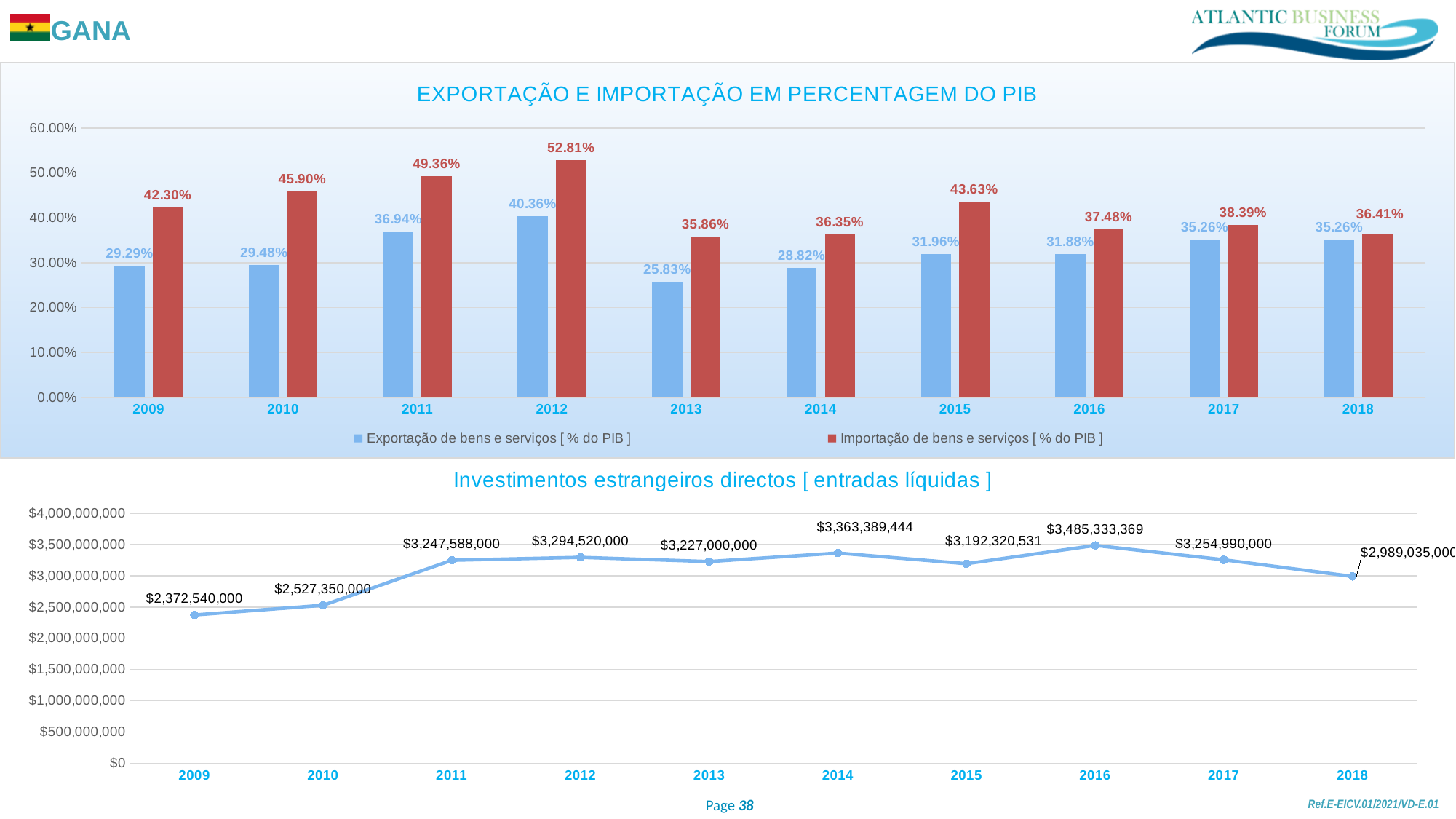
In the chart 'EXPORTAÇÃO E IMPORTAÇÃO EM PERCENTAGEM DO PIB', what is the value of Exportação de bens e serviços in 2013? 25.83% In the chart 'EXPORTAÇÃO E IMPORTAÇÃO EM PERCENTAGEM DO PIB', which year has the lowest Exportação value? 2013 In the chart 'EXPORTAÇÃO E IMPORTAÇÃO EM PERCENTAGEM DO PIB', what is the difference between Importação and Exportação in 2011? 12.42% In the chart 'EXPORTAÇÃO E IMPORTAÇÃO EM PERCENTAGEM DO PIB', how many series does the legend list? 2 In the chart 'Investimentos estrangeiros directos [ entradas líquidas ]', what is the value for 2016? $3,485,333,369 In the chart 'EXPORTAÇÃO E IMPORTAÇÃO EM PERCENTAGEM DO PIB', what kind of chart is it? Bar chart In the chart 'Investimentos estrangeiros directos [ entradas líquidas ]', how many years are plotted? 10 In the chart 'Investimentos estrangeiros directos [ entradas líquidas ]', which year has the lowest value? 2009 In the chart 'Investimentos estrangeiros directos [ entradas líquidas ]', is the value for 2010 greater or less than $3,000,000,000? less In the chart 'EXPORTAÇÃO E IMPORTAÇÃO EM PERCENTAGEM DO PIB', what is the value of Importação de bens e serviços in 2012? 52.81% In the chart 'EXPORTAÇÃO E IMPORTAÇÃO EM PERCENTAGEM DO PIB', which year has the highest Importação value? 2012 In the chart 'Investimentos estrangeiros directos [ entradas líquidas ]', what kind of chart is it? Line chart